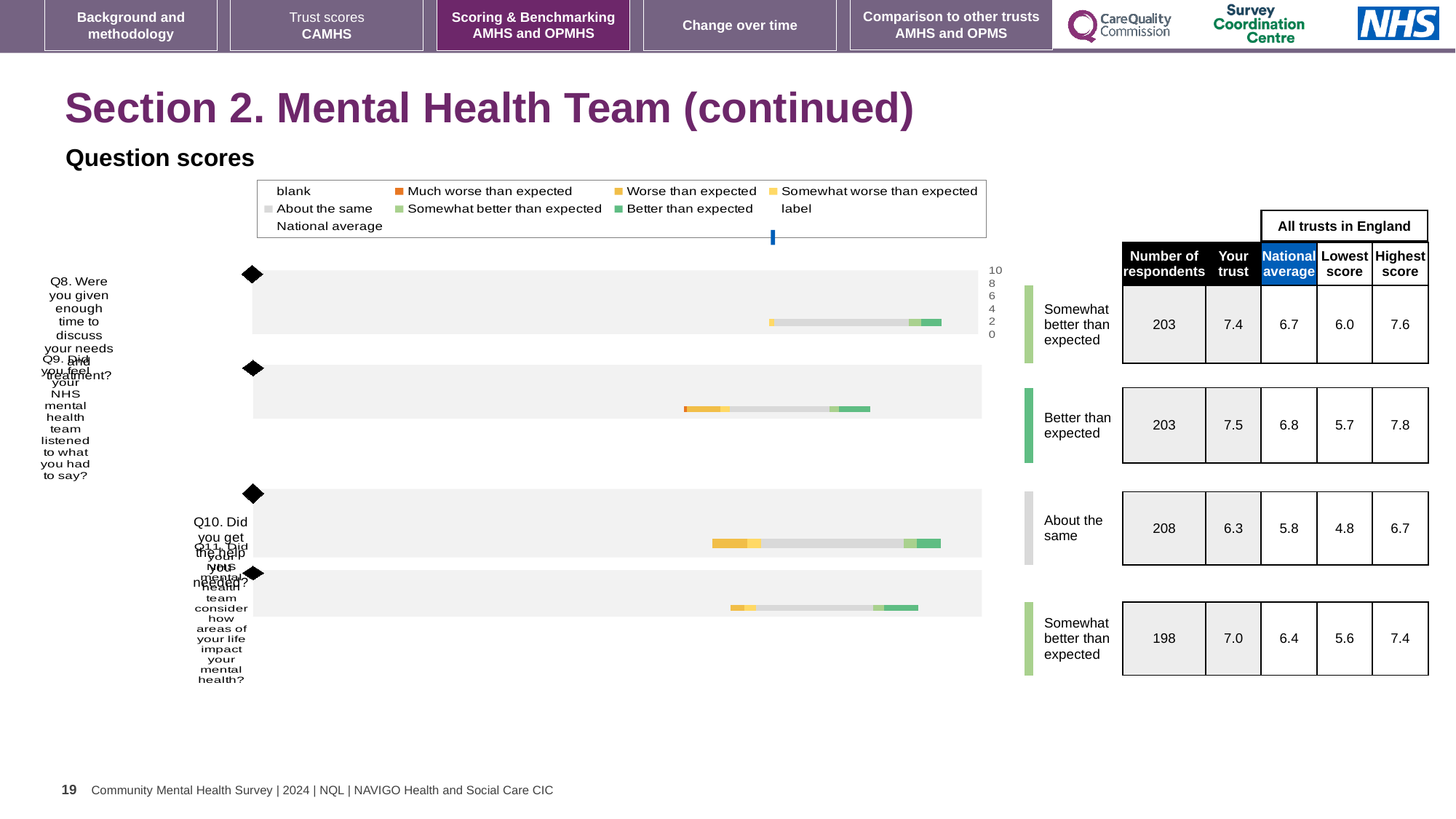
In the table beside the chart, what is the national average for Q9? 6.8 What kind of chart is shown under 'Question scores'? bar chart In the table beside the chart, for Q10 is the 'Your trust' score or the national average larger? Your trust In the table beside the chart, what is the highest score among all trusts in England for Q9? 7.8 In the table beside the chart, which question has the highest 'Your trust' score? Q9 In the table beside the chart, what is the difference between the 'Your trust' score and the national average for Q8? 0.7 How many questions (bars) are plotted in the Question scores chart? 4 What is the heading above the chart on this slide? Question scores In the table beside the chart, which question has the lowest 'Your trust' score? Q10 In the table beside the chart, how many respondents answered Q11? 198 Which legend entry in the Question scores chart is shown in orange? Much worse than expected In the table beside the chart, what is the 'Your trust' score for Q8? 7.4